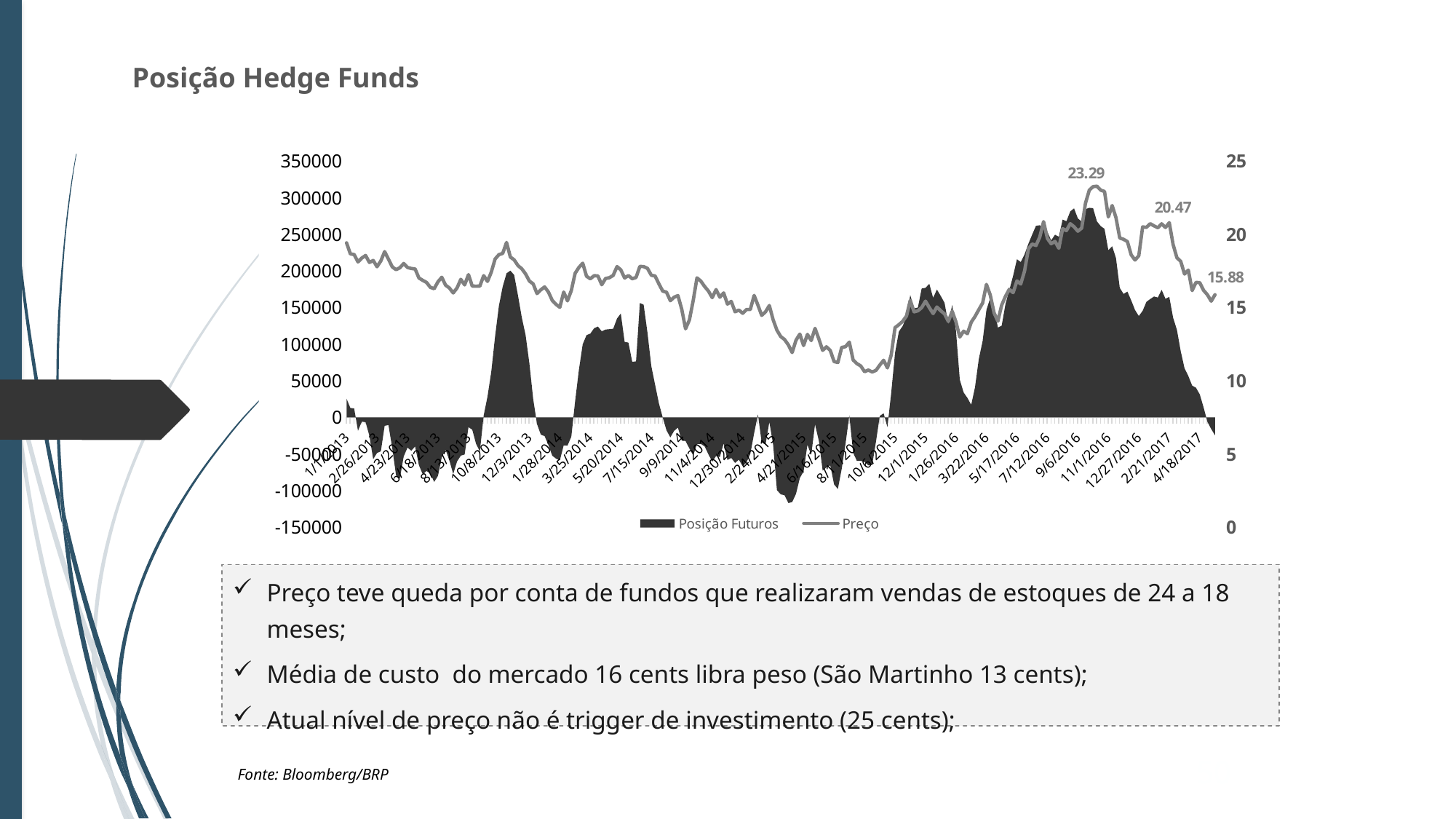
Which labelled Preço value is larger, 23.29 or 20.47? 23.29 What labelled value does the Preço line show between the 23.29 peak and the final 15.88 point? 20.47 Is the lowest value of Posição Futuros, around 4/21/2015 to 6/16/2015, greater or less than -50000? less What is the maximum value shown on the right-hand axis of the chart? 25 Does the Preço line rise or fall between 1/1/2013 and 10/6/2015? Falls What are the two series named in the chart legend? Posição Futuros and Preço What is the last labelled value of the Preço line, near 4/18/2017? 15.88 How many series does the chart legend list? 2 What is the difference between the labelled Preço values 23.29 and 15.88? 7.41 What is the highest labelled value of the Preço line? 23.29 Is the peak value of Posição Futuros around 9/6/2016 greater or less than 250000? greater What kind of chart is shown on the slide? Combined area and line chart